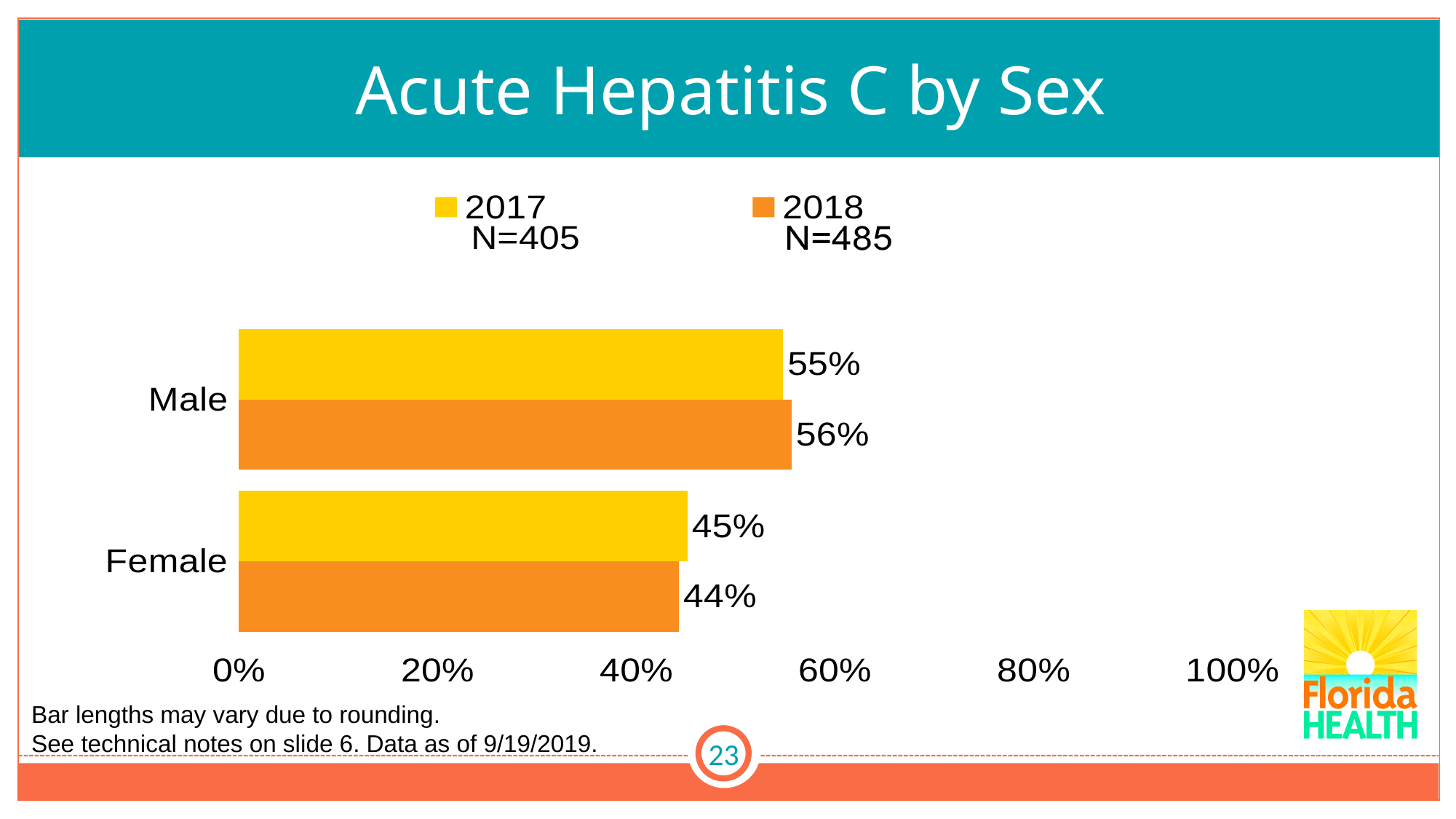
What percentage of acute hepatitis C cases were male in 2018? 56% How many series does the legend list? 2 What is the difference between the male and female percentages in 2018? 12% What percentage of acute hepatitis C cases were female in 2018? 44% What kind of chart is shown on the slide? Bar chart What is the difference between the 2017 and 2018 percentages for females? 1% What is the N value for 2018 shown in the legend? N=485 Which sex had the lower share of acute hepatitis C cases in 2017? Female What percentage of acute hepatitis C cases were male in 2017? 55% What percentage of acute hepatitis C cases were female in 2017? 45% Which sex had the higher share of acute hepatitis C cases in 2018? Male How many sex categories are shown on the chart? 2